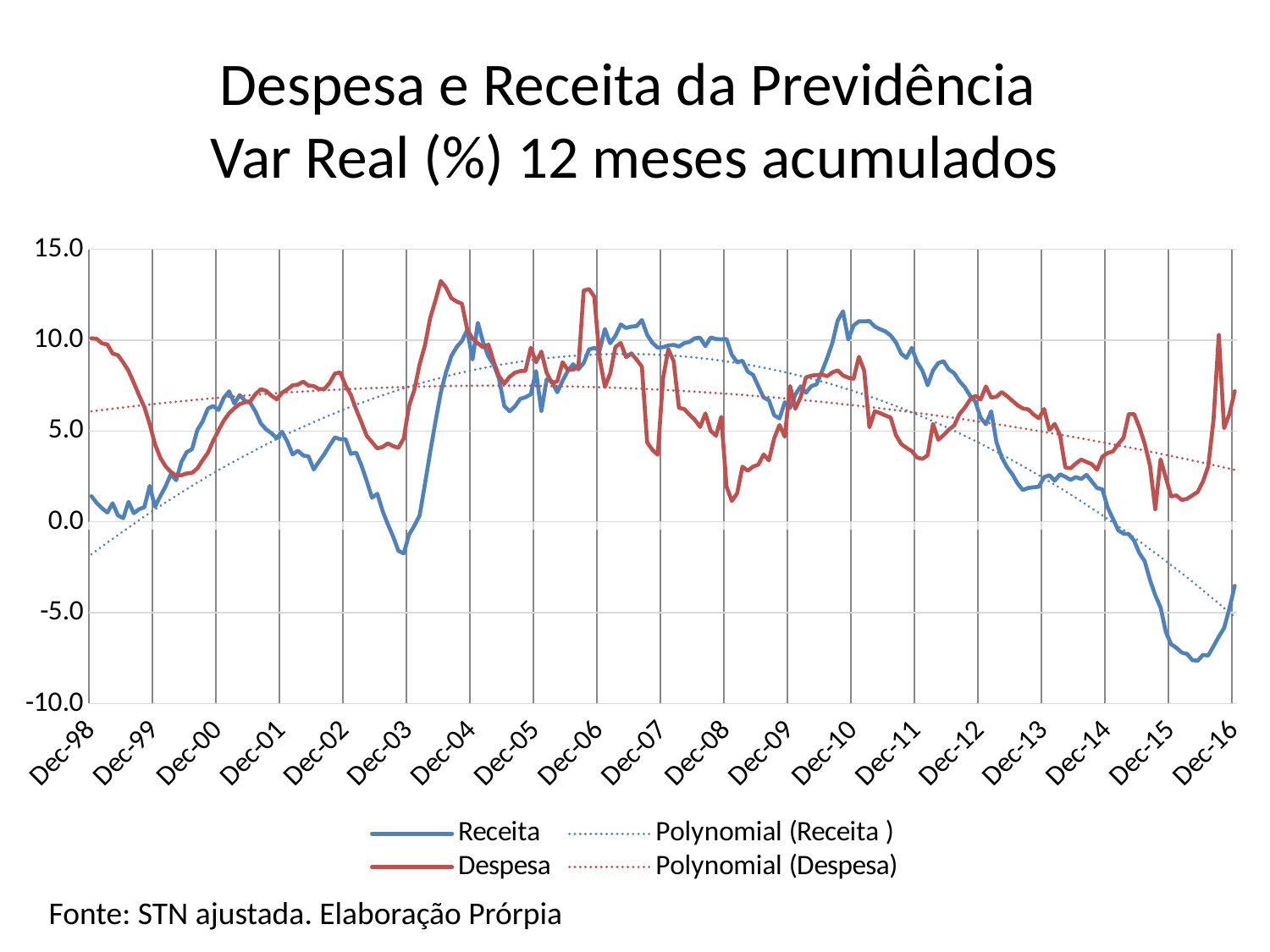
How many date labels are shown on the x axis? 19 Does the Receita line rise or fall between Dec-12 and Dec-15? fall At Dec-10, which series has the larger value, Receita or Despesa? Receita What is the source cited below the chart? STN ajustada. Elaboração Prórpia What colour is the Despesa line? red Is the value of Despesa at Dec-08 greater or less than 5.0? less At Dec-15, which series has the larger value, Receita or Despesa? Despesa Is the value of Receita at Dec-15 greater or less than -5.0? less Is the value of Receita at Dec-10 greater or less than 10.0? greater How many entries does the legend list? 4 What kind of chart is shown on the slide? line chart